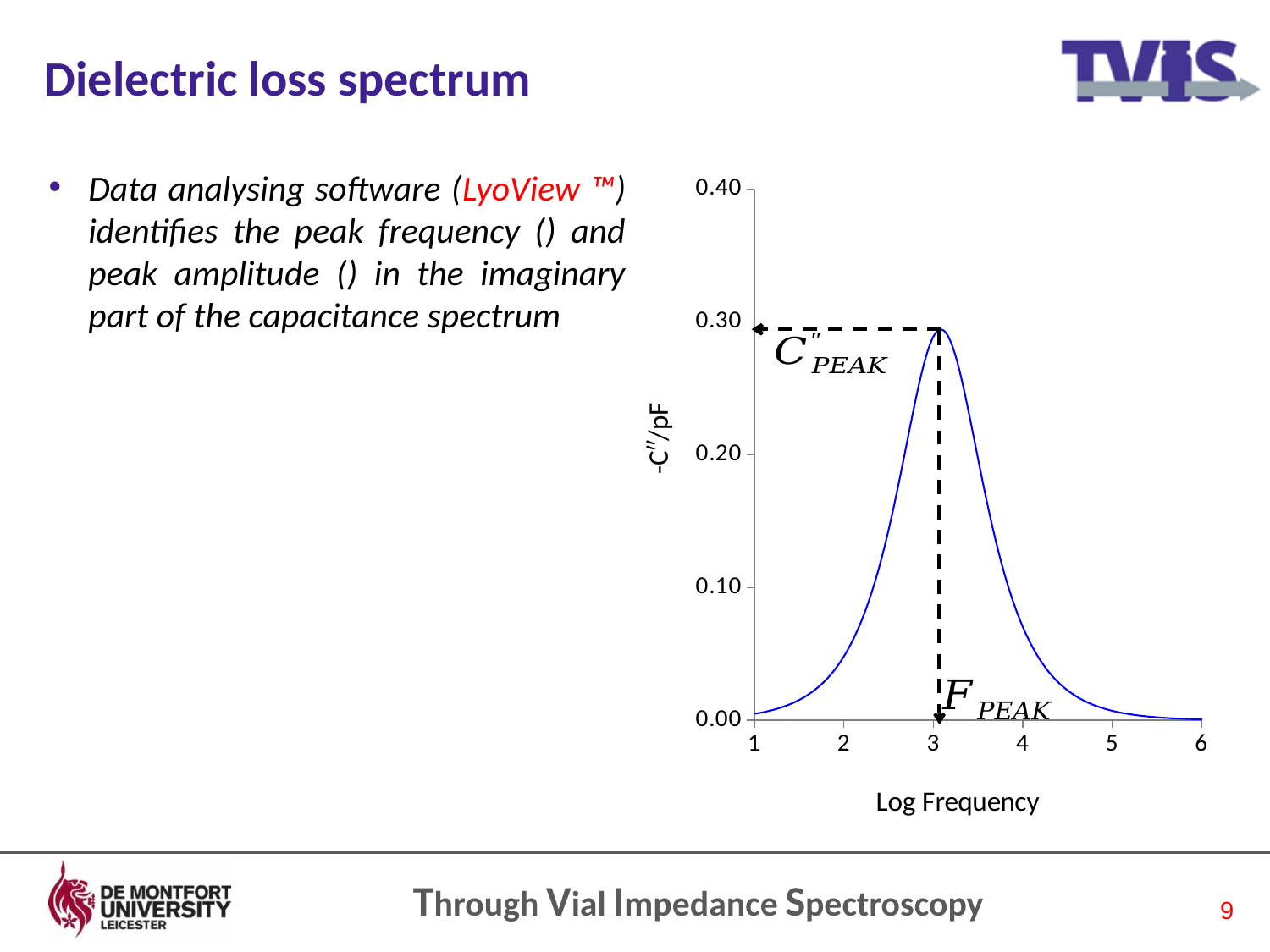
Does the curve rise or fall as log frequency increases from 3 to 6? fall Is the value of the curve at log frequency 3 larger or smaller than the value at log frequency 5? larger Is the value of the curve at log frequency 1 greater or less than 0.10? less Is the peak value of the curve greater or less than 0.20? greater Does the curve rise or fall as log frequency increases from 1 to 3? rise What is the label of the x axis of the chart? Log Frequency Is the value of the curve at log frequency 2 greater or less than 0.10? less What is the highest value shown on the y axis of the chart? 0.40 What is the label of the y axis of the chart? -C''/pF What kind of chart is shown on the slide? line chart